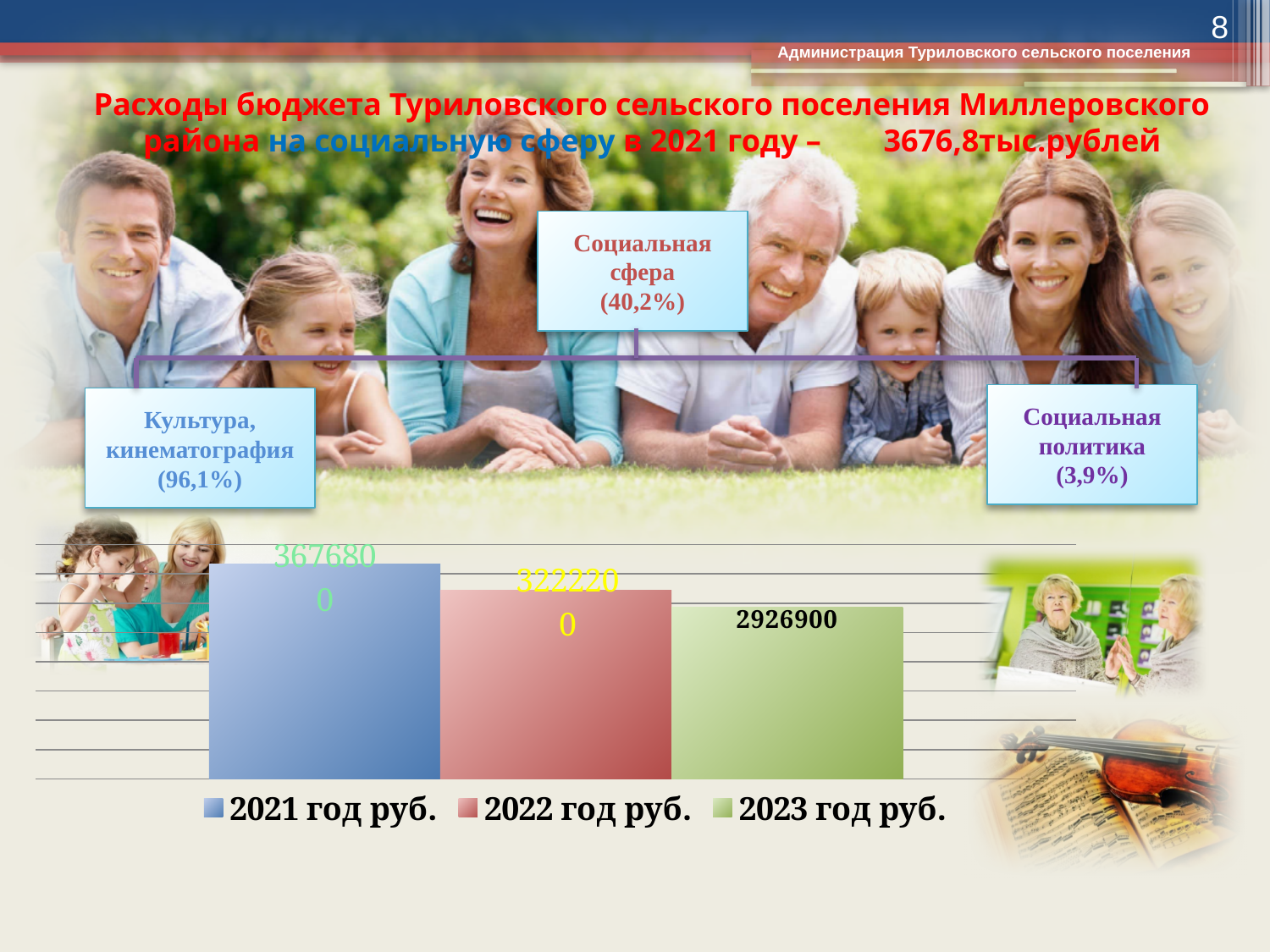
Which is larger, the value for 2022 год руб. or the value for 2023 год руб.? 2022 год руб. What is the value shown for 2023 год руб. on the bar chart? 2926900 What is the value shown for 2021 год руб. on the bar chart? 3676800 What is the value shown for 2022 год руб. on the bar chart? 3222200 How many series does the chart legend list? 3 Which year has the lowest value on the bar chart? 2023 год руб. What is the difference between the values for 2022 год руб. and 2023 год руб.? 295300 What is the difference between the values for 2021 год руб. and 2022 год руб.? 454600 Which year has the highest value on the bar chart? 2021 год руб. How many bars are plotted on the chart? 3 What is the difference between the values for 2021 год руб. and 2023 год руб.? 749900 What kind of chart is shown on the slide? bar chart